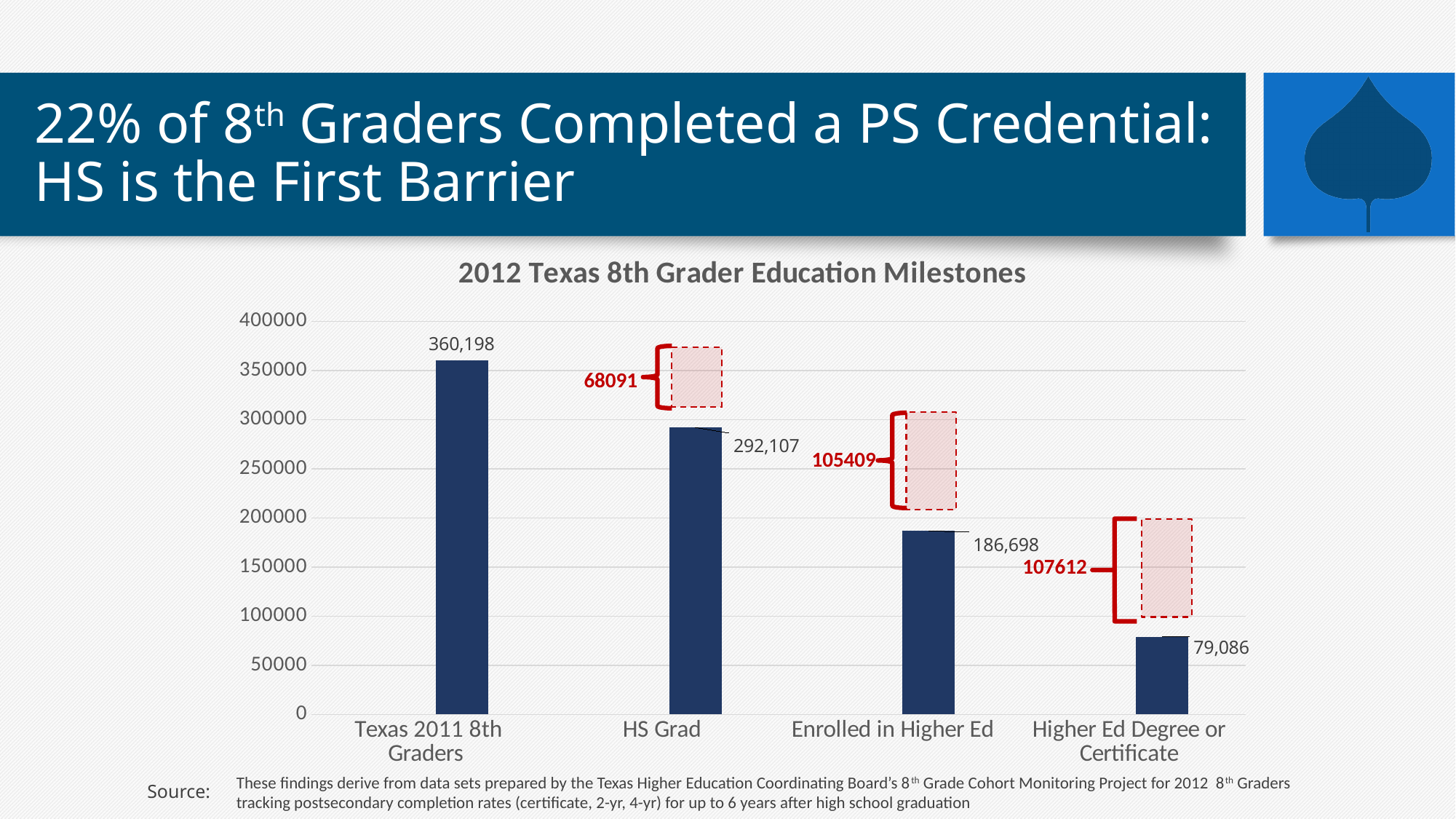
Which category has the highest value? Texas 2011 8th Graders What is the value for Higher Ed Degree or Certificate? 79,086 What is the value for Enrolled in Higher Ed? 186,698 How many categories are shown on the x axis? 4 What is the value for HS Grad? 292,107 Which category has the lowest value? Higher Ed Degree or Certificate What is the value for Texas 2011 8th Graders? 360,198 Which is larger, the value for HS Grad or the value for Enrolled in Higher Ed? HS Grad What kind of chart is shown on the slide? Bar chart What is the difference between the Enrolled in Higher Ed value and the Higher Ed Degree or Certificate value? 107,612 What is the title of the chart? 2012 Texas 8th Grader Education Milestones What is the difference between the Texas 2011 8th Graders value and the HS Grad value? 68,091